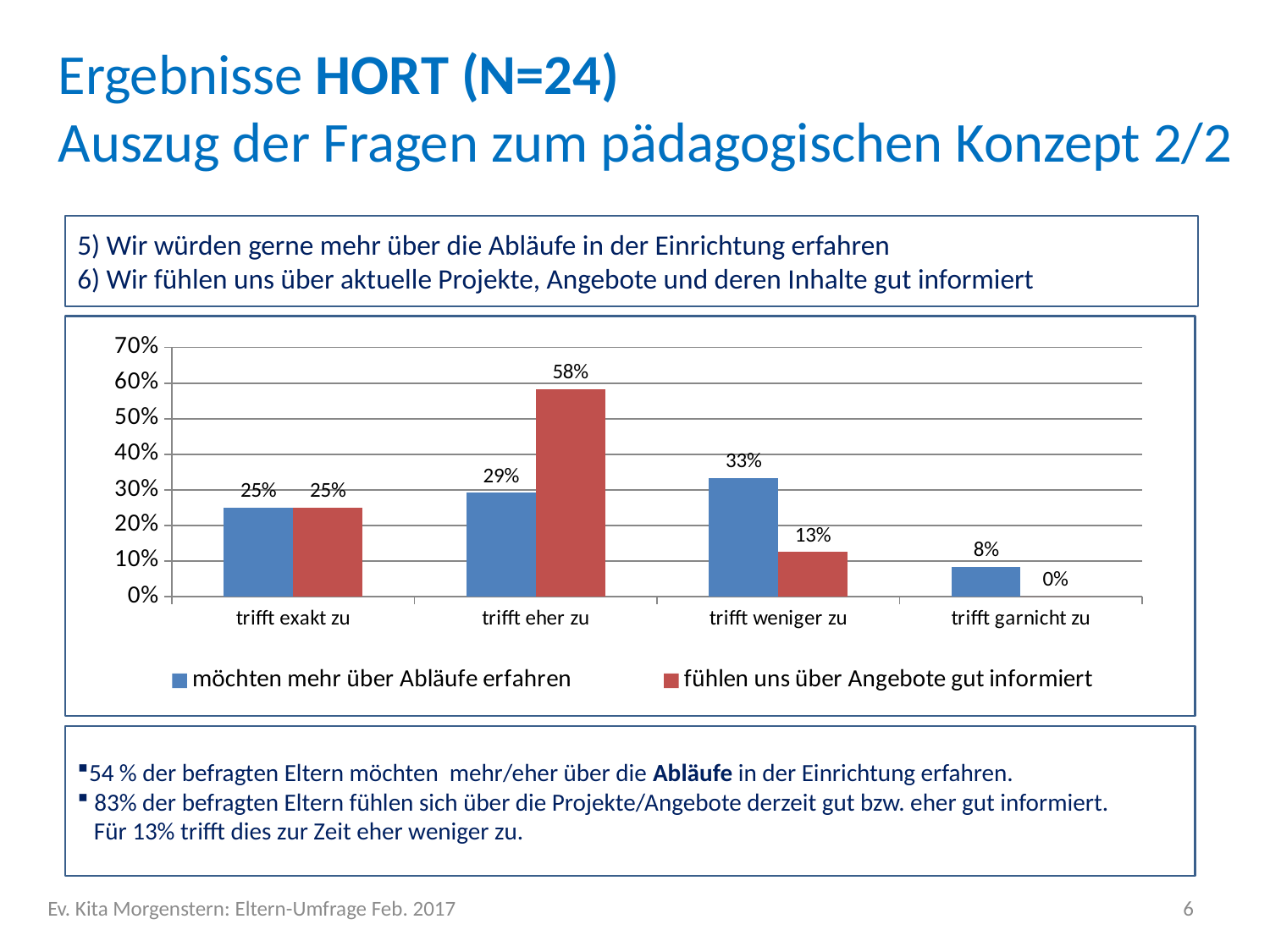
What kind of chart is shown on the slide? bar chart What is the value for "fühlen uns über Angebote gut informiert" in the category "trifft eher zu"? 58% What is the value for "möchten mehr über Abläufe erfahren" in the category "trifft garnicht zu"? 8% In the category "trifft weniger zu", which series has the larger value? möchten mehr über Abläufe erfahren How many categories are shown on the x axis of the chart? 4 In which category does the series "möchten mehr über Abläufe erfahren" have its lowest value? trifft garnicht zu What is the difference between the two series in the category "trifft eher zu"? 29% In which category does the series "fühlen uns über Angebote gut informiert" reach its highest value? trifft eher zu Which colour represents the series "fühlen uns über Angebote gut informiert" in the chart? red How many series does the chart legend list? 2 What is the value for "fühlen uns über Angebote gut informiert" in the category "trifft garnicht zu"? 0% What is the value for "möchten mehr über Abläufe erfahren" in the category "trifft weniger zu"? 33%